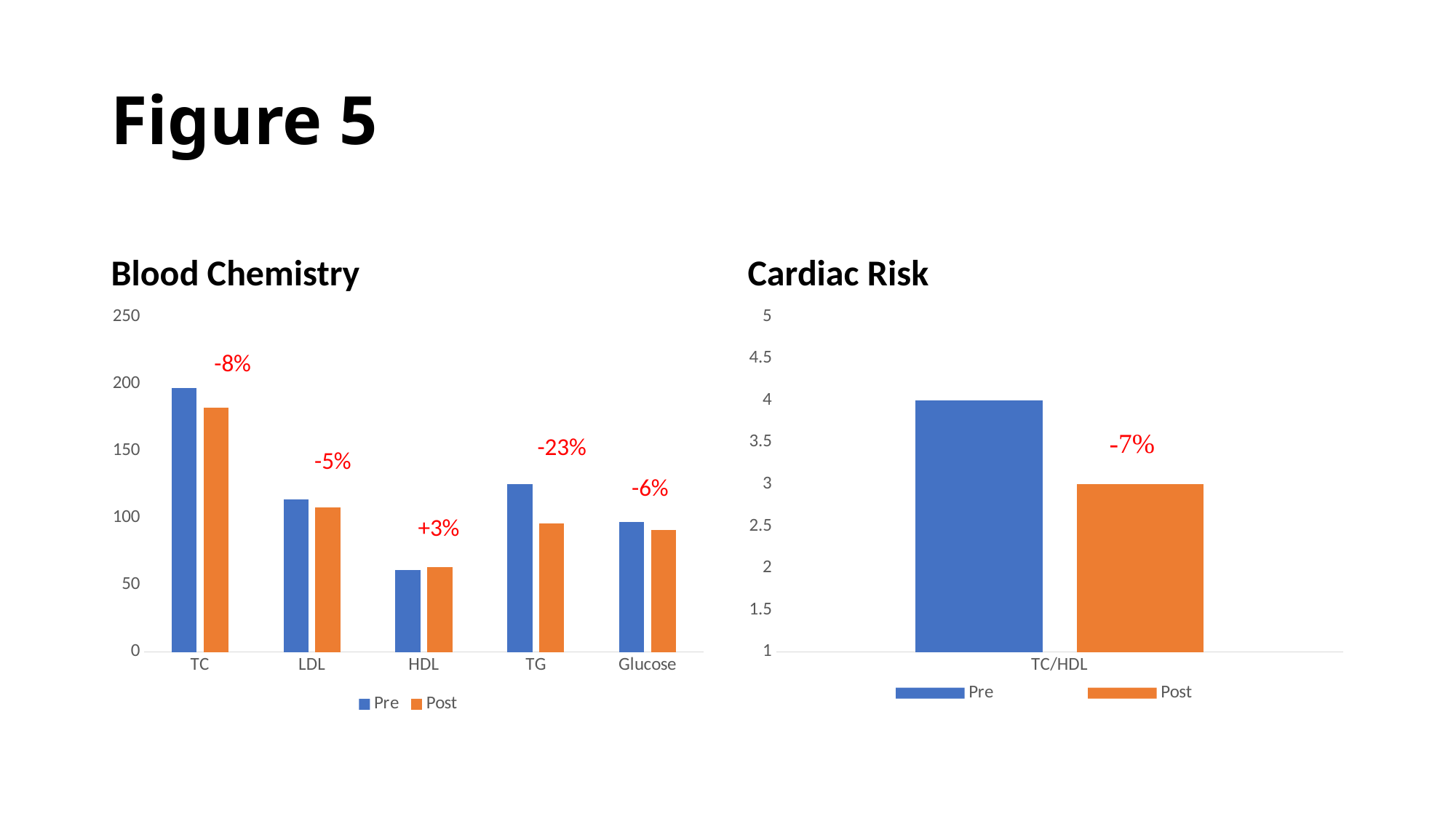
How many categories are shown on the x axis of the Blood Chemistry chart? 5 In the Cardiac Risk chart, what percentage change is labelled above the Post bar? -7% How many series does the legend of the Blood Chemistry chart list? 2 What kind of chart is the Blood Chemistry chart? bar chart In the Blood Chemistry chart, what percentage change is labelled above the TG bars? -23% In the Cardiac Risk chart, is the Post value for TC/HDL greater or less than 3.5? less In the Blood Chemistry chart, which category has the lowest Pre value? HDL In the Blood Chemistry chart, which is larger for LDL, the Pre value or the Post value? Pre In the Blood Chemistry chart, what percentage change is labelled above the HDL bars? +3% In the Blood Chemistry chart, which category has the highest Pre value? TC In the Blood Chemistry chart, is the Pre value for TC greater or less than 150? greater